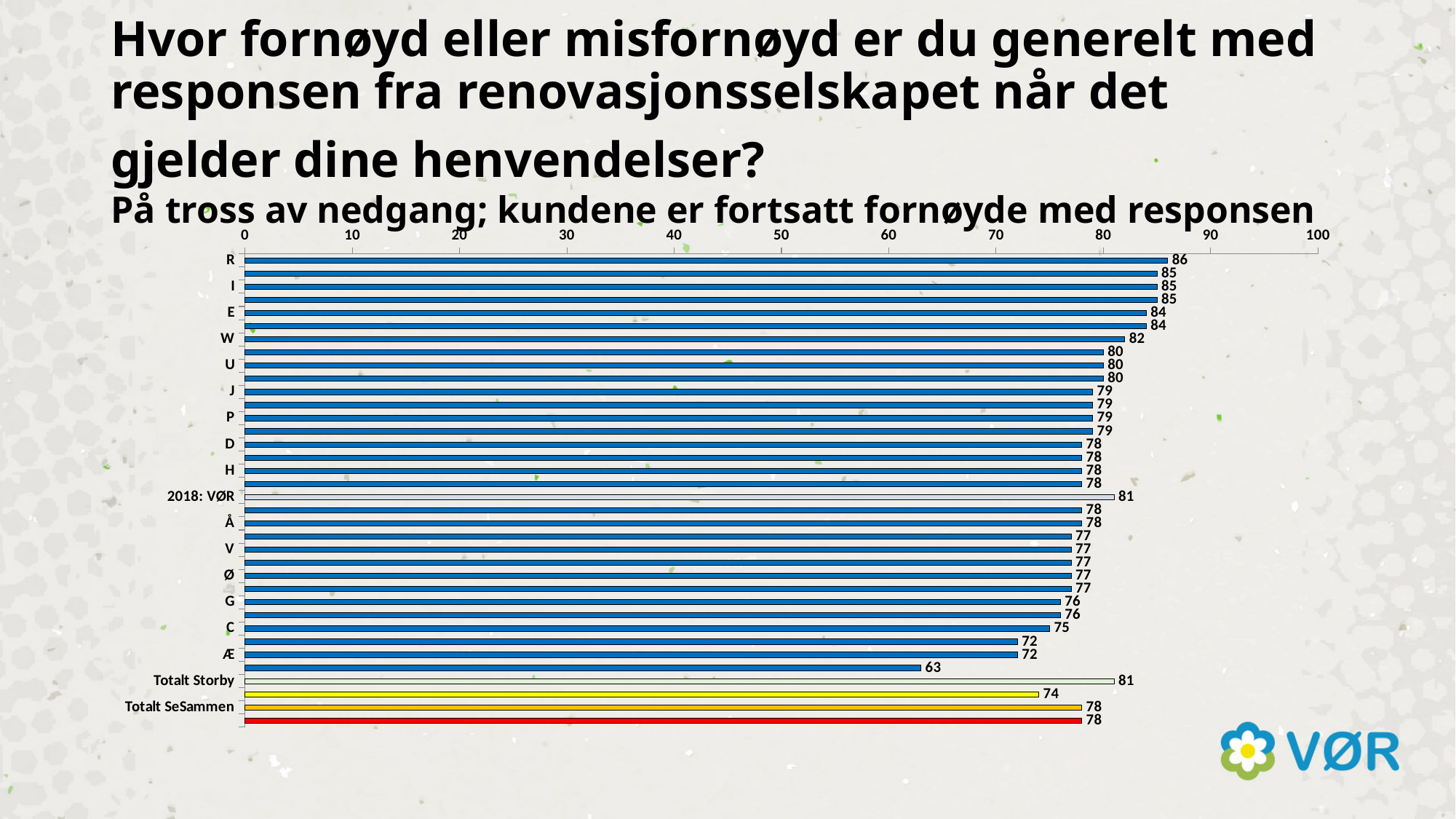
Is the value for the red bar at the bottom of the chart greater or less than 70? greater What is the value for Æ? 72 What is the maximum value shown on the horizontal axis? 100 Which labelled category has the highest value? R What is the value for 2018: VØR? 81 What is the value for Totalt Storby? 81 What is the lowest value shown on the chart? 63 What is the value for Totalt SeSammen? 78 What is the value for R? 86 What kind of chart is shown on the slide? bar chart Which is larger, the value for Totalt Storby or the value for Totalt SeSammen? Totalt Storby What is the difference between the value for R and the value for Totalt SeSammen? 8